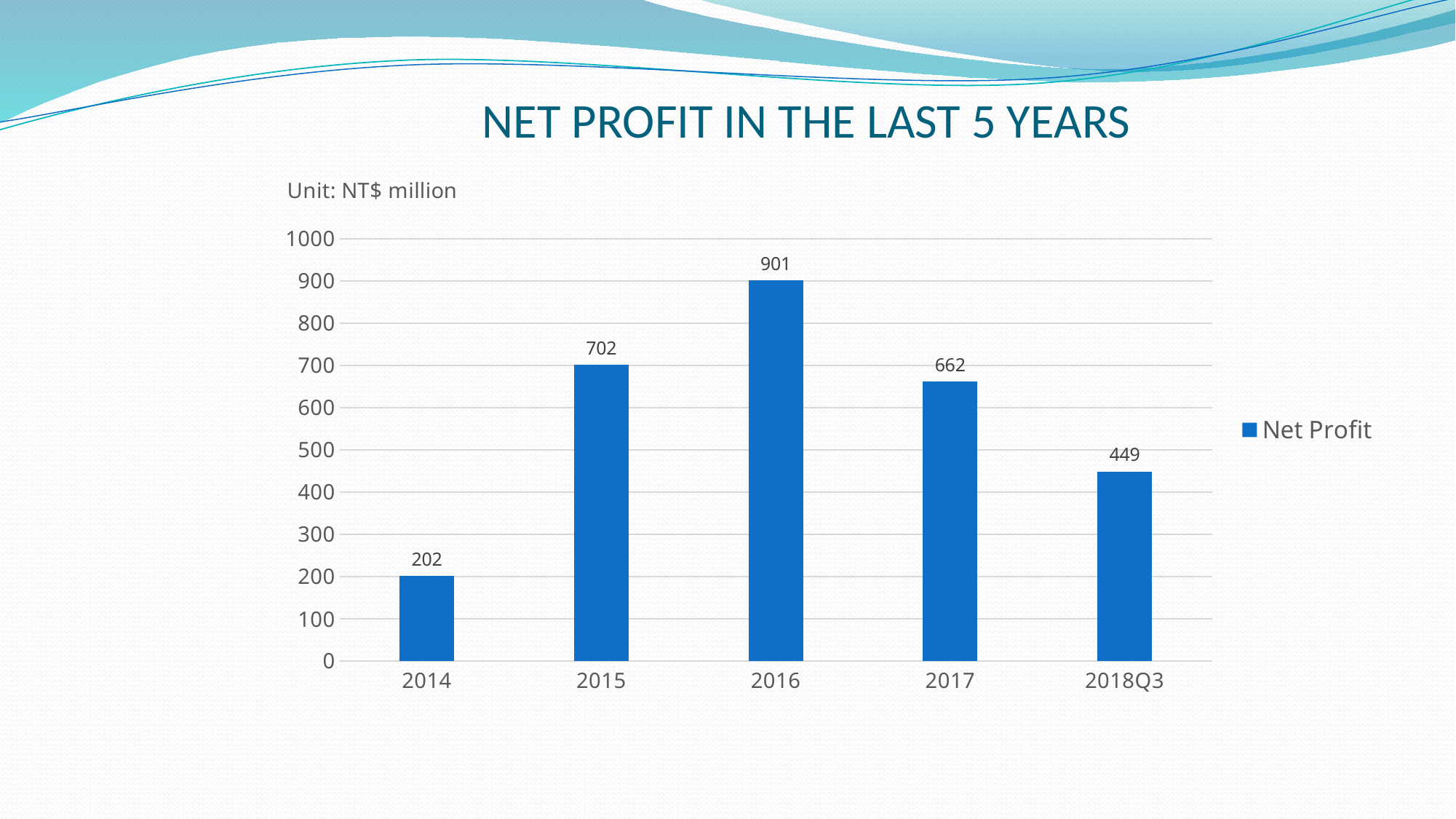
Which is larger, the net profit in 2015 or in 2017? 2015 What is the difference between the net profit in 2015 and 2014? 500 What kind of chart is shown on the slide? bar chart What is the net profit for 2014? 202 Is the net profit for 2018Q3 greater or less than 500? less Which year has the lowest net profit? 2014 What unit is stated for the values in the chart? NT$ million What is the difference between the net profit in 2016 and 2017? 239 What is the net profit for 2016? 901 What is the net profit for 2018Q3? 449 Which year has the highest net profit? 2016 How many categories are shown on the x axis? 5